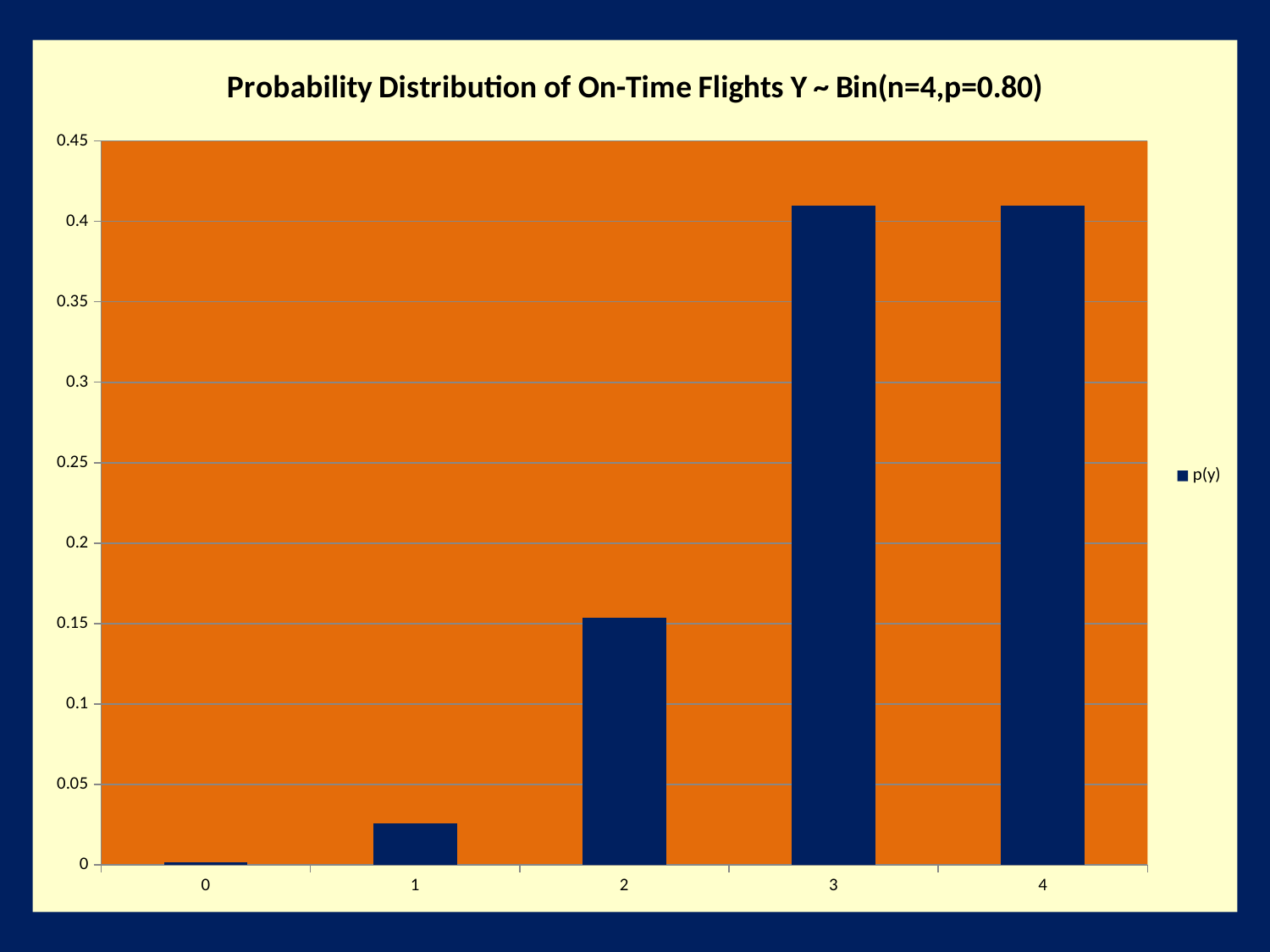
How many categories are shown on the x axis? 5 How many series does the legend list? 1 Which is larger, the value for category 2 or the value for category 3? 3 What is the title of the chart? Probability Distribution of On-Time Flights Y ~ Bin(n=4,p=0.80) Is the value for category 4 greater or less than 0.3? greater Is the value for category 3 greater or less than 0.35? greater Which is larger, the value for category 1 or the value for category 2? 2 Is the value for category 1 greater or less than 0.05? less What kind of chart is shown on the slide? bar chart Which category has the lowest value of p(y)? 0 What series name is shown in the legend? p(y)